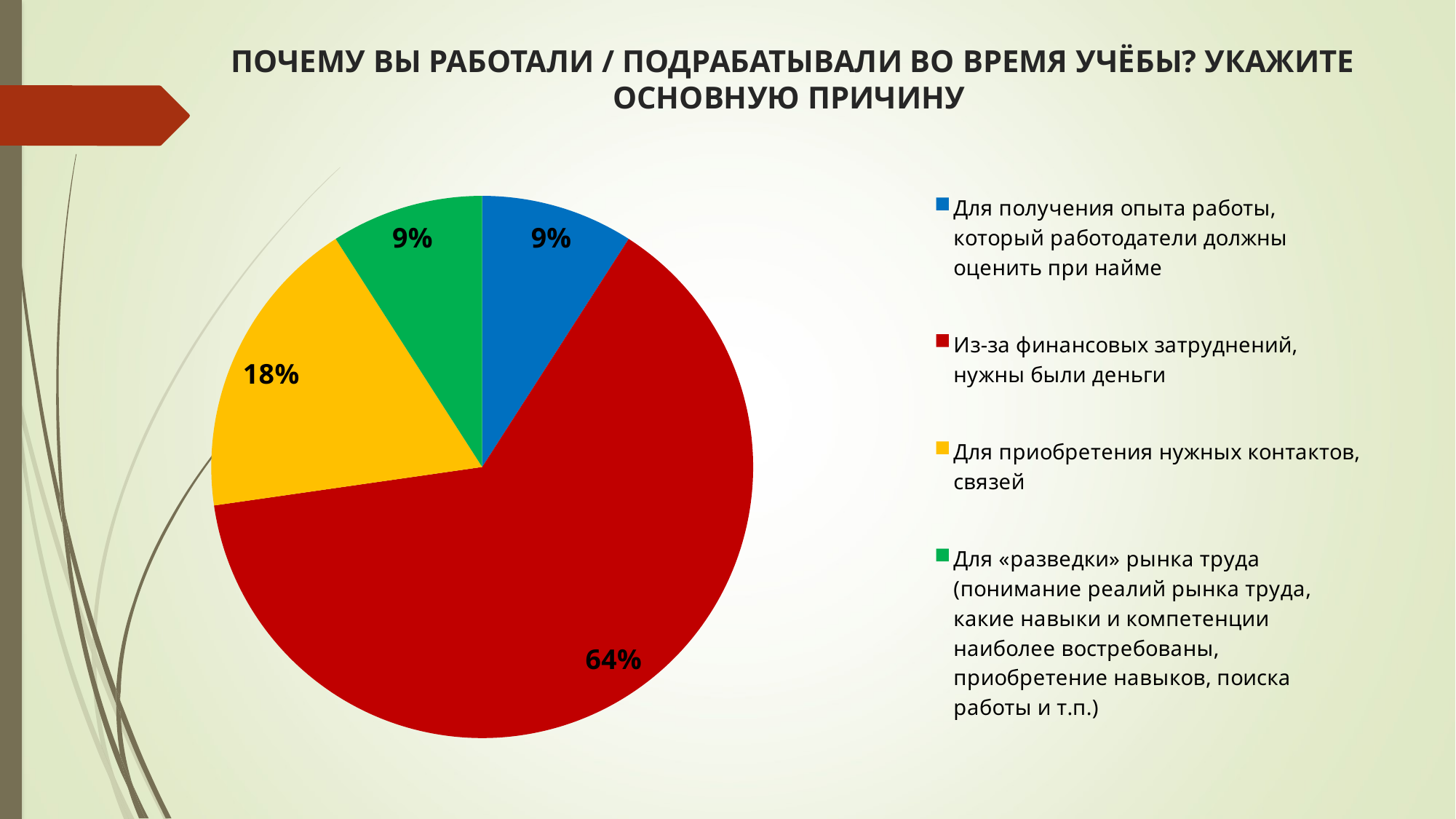
What colour is the slice for "Из-за финансовых затруднений, нужны были деньги"? Red What is the difference in percentage points between the slice for "Из-за финансовых затруднений, нужны были деньги" and the slice for "Для приобретения нужных контактов, связей"? 46 percentage points What kind of chart is shown on the slide? Pie chart What share of the pie is labelled "Для «разведки» рынка труда"? 9% Which is larger: the slice for "Для приобретения нужных контактов, связей" or the slice for "Для получения опыта работы"? Для приобретения нужных контактов, связей What share of the pie is labelled "Для получения опыта работы, который работодатели должны оценить при найме"? 9% What share of the pie is labelled "Из-за финансовых затруднений, нужны были деньги"? 64% What is the title of the chart on the slide? ПОЧЕМУ ВЫ РАБОТАЛИ / ПОДРАБАТЫВАЛИ ВО ВРЕМЯ УЧЁБЫ? УКАЖИТЕ ОСНОВНУЮ ПРИЧИНУ What share of the pie is labelled "Для приобретения нужных контактов, связей"? 18% How many slices does the pie chart have? 4 Which category has the largest slice of the pie? Из-за финансовых затруднений, нужны были деньги How many entries does the legend list? 4